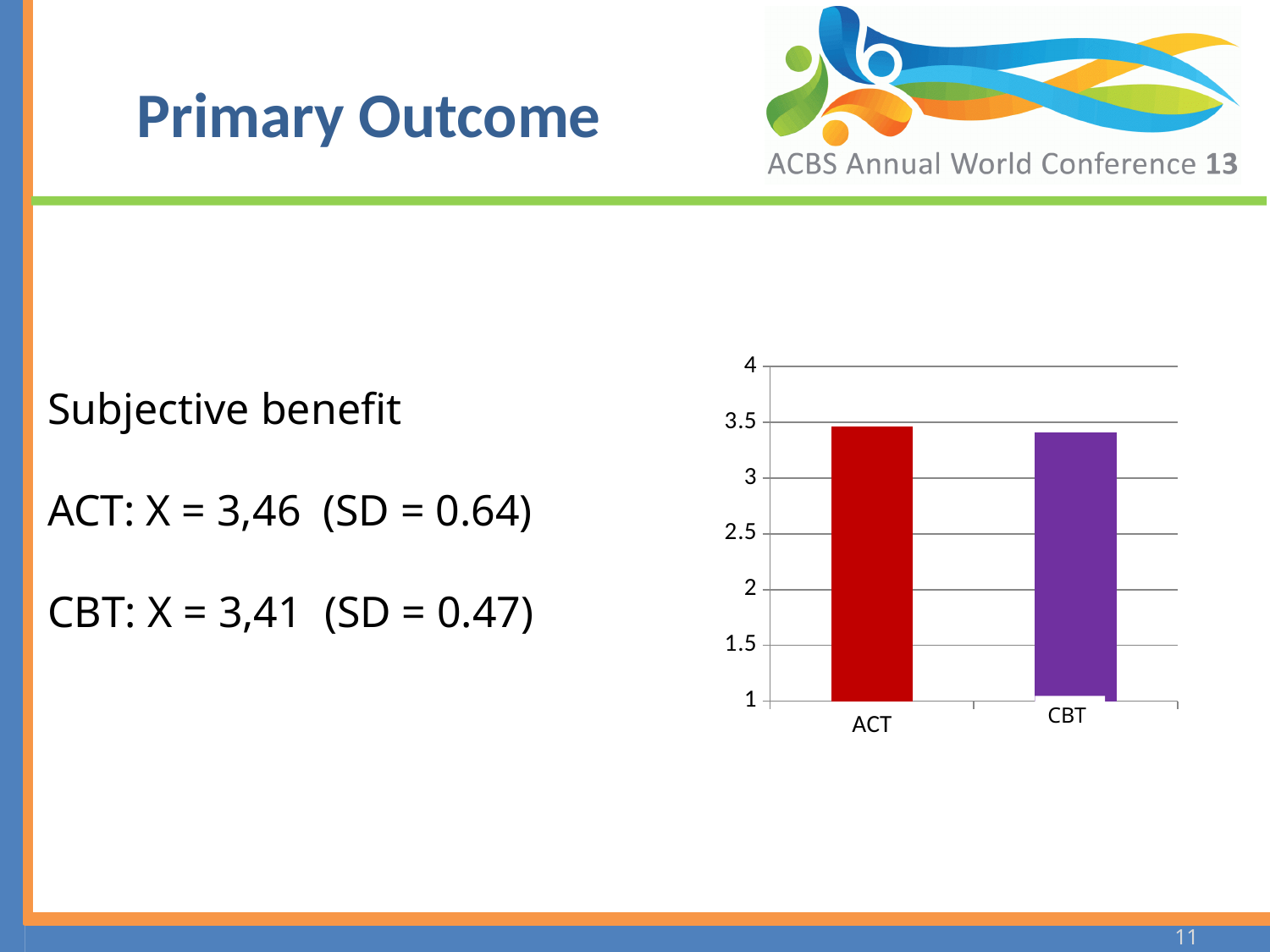
What is the subjective benefit value for CBT? 3,41 What is the subjective benefit value for ACT? 3,46 Which category has the lowest value in the chart? CBT What is the highest value shown on the vertical axis? 4 Is the value for ACT greater or less than 3? greater Which category has the higher bar, ACT or CBT? ACT What kind of chart is shown on the slide? bar chart What is the difference between the ACT and CBT values? 0,05 Is the value for CBT greater or less than 3.5? less How many bars (categories) does the chart show? 2 What colour is the bar for CBT? purple